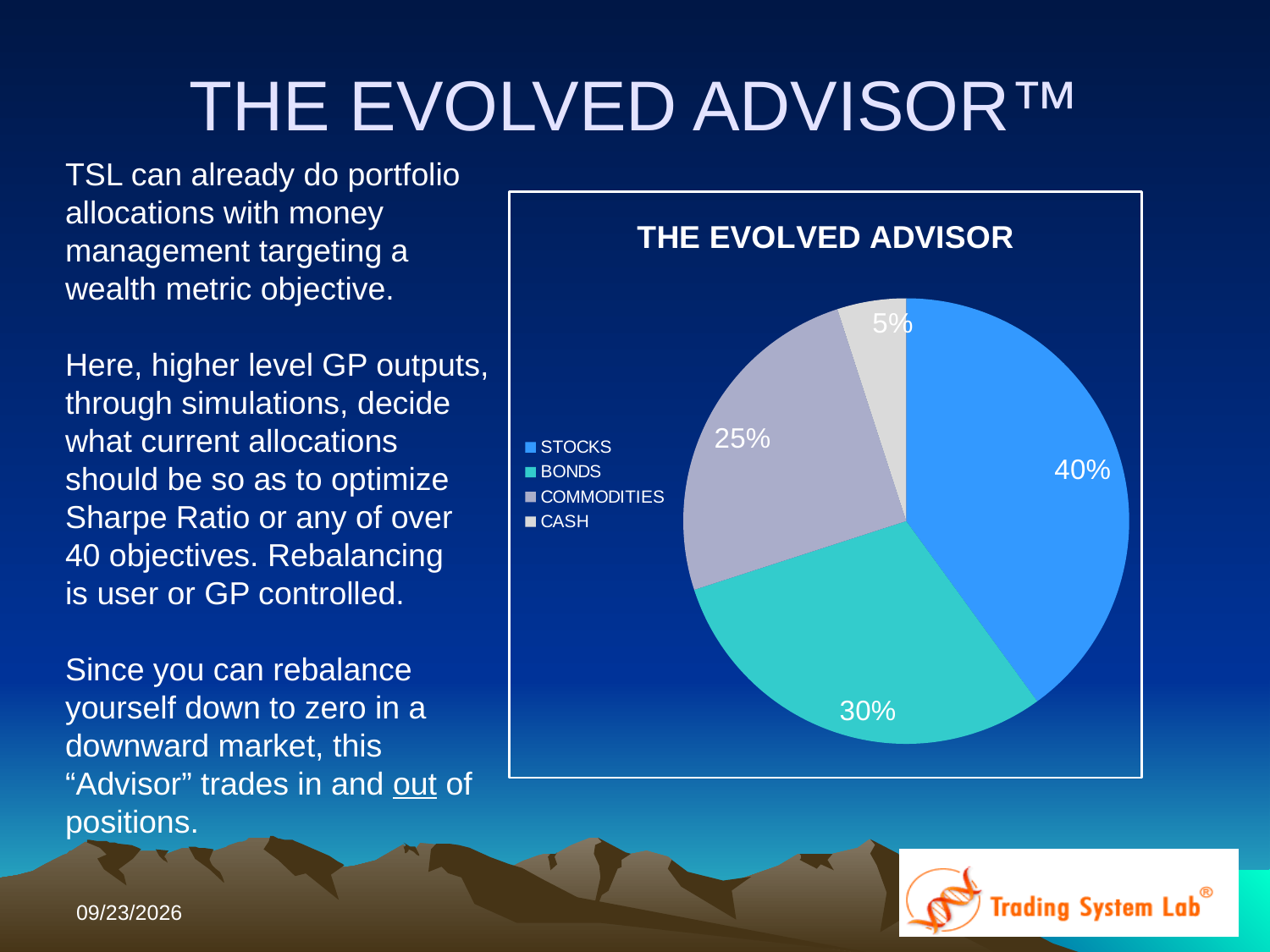
What share of the pie does COMMODITIES represent? 25% What share of the pie does STOCKS represent? 40% Which slice is larger, COMMODITIES or CASH? COMMODITIES What is the title of the chart? THE EVOLVED ADVISOR How many entries does the legend list? 4 What share of the pie does BONDS represent? 30% What share of the pie does CASH represent? 5% How many categories are shown in the pie chart? 4 Which category has the smallest slice of the pie? CASH Which category has the largest slice of the pie? STOCKS What kind of chart is shown on the slide? Pie chart What is the difference in percentage points between the STOCKS and BONDS slices? 10